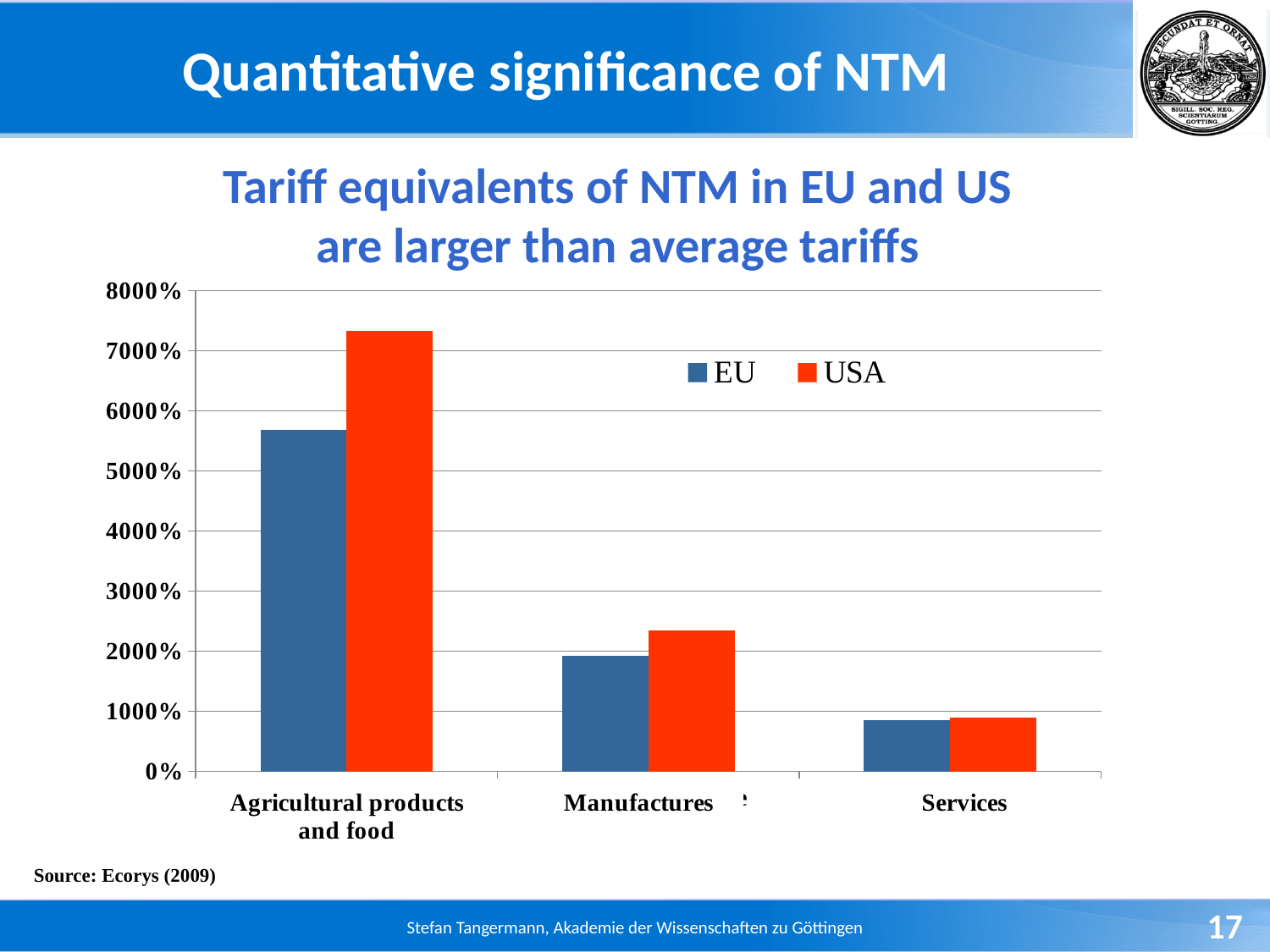
What colour represents the USA series in the chart? Red Is the EU value for Agricultural products and food greater or less than 6000%? less How many series does the legend list? 2 For Agricultural products and food, which is larger, the EU value or the USA value? USA What kind of chart is shown on the slide? Bar chart Which category has the lowest EU value? Services How many categories are shown on the x axis? 3 Which category has the highest USA value? Agricultural products and food Do the USA values rise or fall moving from Agricultural products and food to Services along the x axis? fall Is the USA value for Agricultural products and food greater or less than 7000%? greater For Manufactures, which is larger, the EU value or the USA value? USA